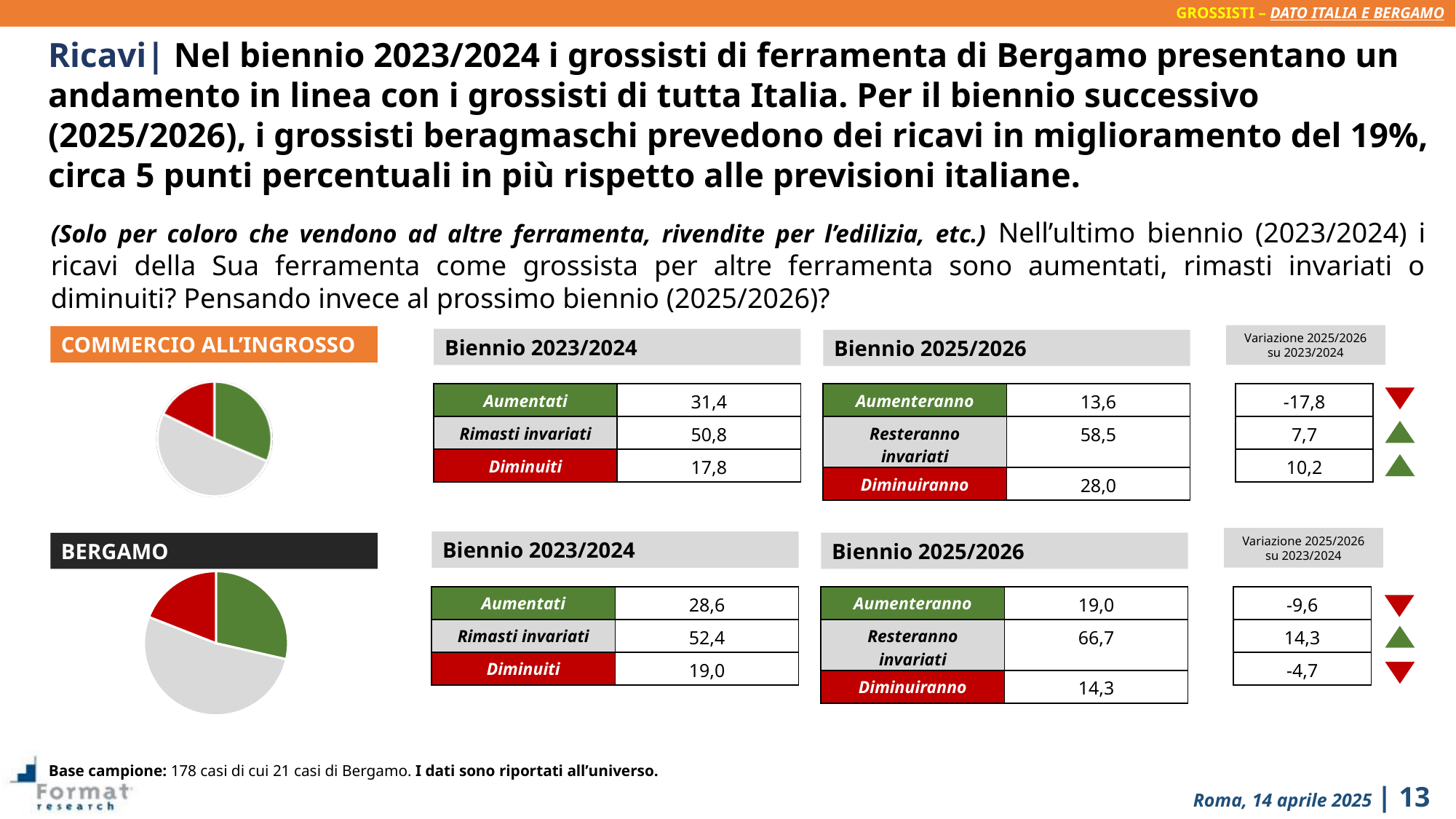
In the COMMERCIO ALL'INGROSSO pie chart (Biennio 2023/2024), what is the value for Rimasti invariati? 50,8 In the BERGAMO pie chart (Biennio 2023/2024), what is the value for Aumentati? 28,6 In the BERGAMO pie chart (Biennio 2023/2024), what is the value for Rimasti invariati? 52,4 In the COMMERCIO ALL'INGROSSO pie chart (Biennio 2023/2024), what is the value for Diminuiti? 17,8 In the COMMERCIO ALL'INGROSSO pie chart (Biennio 2023/2024), which category has the largest slice? Rimasti invariati In the COMMERCIO ALL'INGROSSO pie chart (Biennio 2023/2024), which category has the smallest slice? Diminuiti In the BERGAMO pie chart (Biennio 2023/2024), which is larger, Aumentati or Diminuiti? Aumentati What kind of chart is shown next to the COMMERCIO ALL'INGROSSO label? Pie chart In the COMMERCIO ALL'INGROSSO pie chart (Biennio 2023/2024), what is the difference between Aumentati and Diminuiti? 13,6 What colour is the Diminuiti slice in the BERGAMO pie chart? Red How many slices does the BERGAMO pie chart have? 3 In the BERGAMO pie chart (Biennio 2023/2024), what is the difference between Rimasti invariati and Aumentati? 23,8